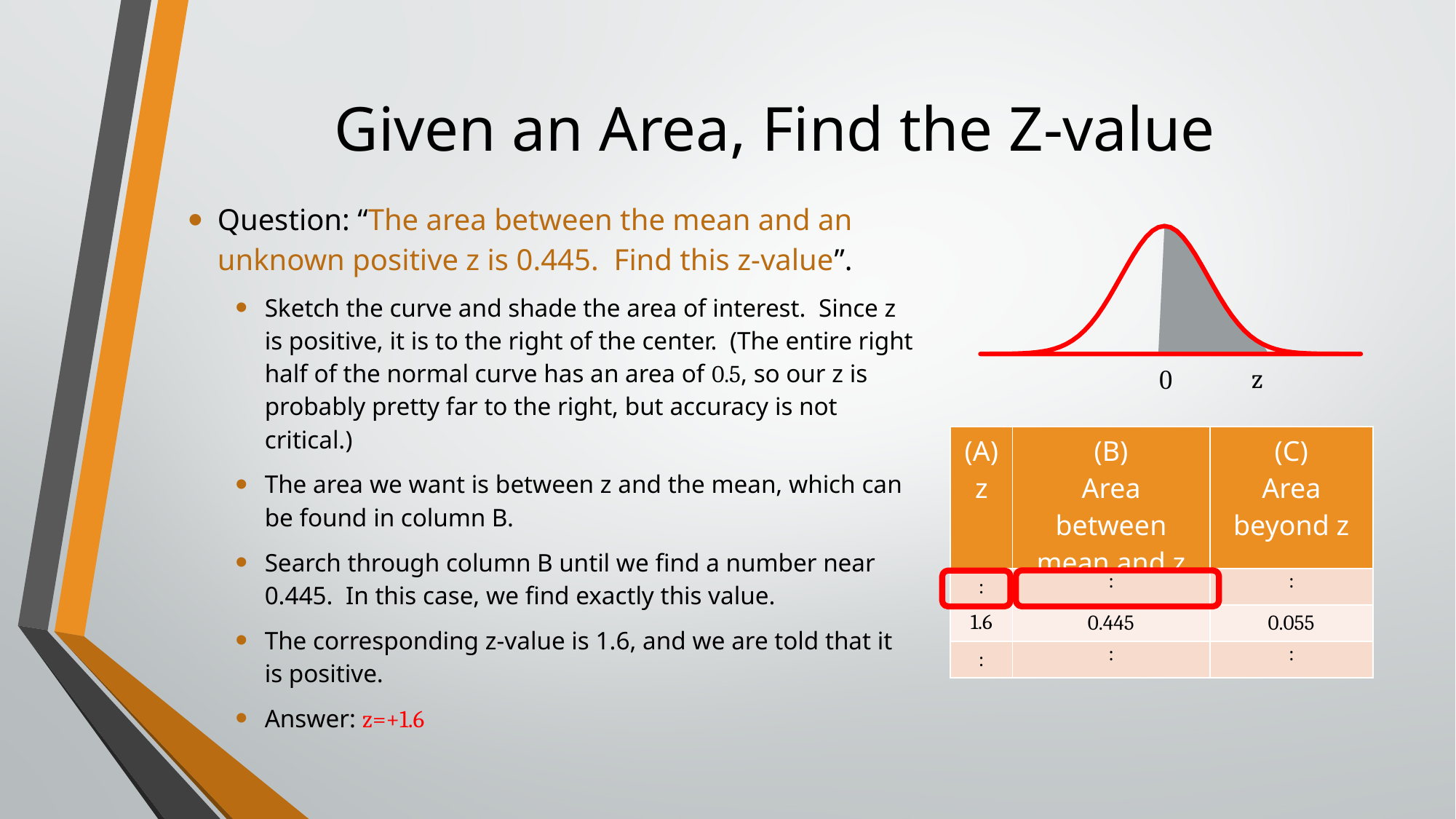
In the table, what is the value in column (C), Area beyond z, for z = 1.6? 0.055 In the table, what is the total of the column (B) and column (C) values for z = 1.6? 0.5 On the normal curve diagram, is the shaded region to the left or right of 0? Right In the table, what is the difference between the area between mean and z and the area beyond z for z = 1.6? 0.39 How many columns does the table have? 3 What kind of graphic is shown at the top right of the slide? A normal curve (bell curve) with a shaded area In the table, which is larger for z = 1.6: the area between mean and z, or the area beyond z? Area between mean and z Is the column (B) value for z = 1.6 greater or less than 0.4? greater What two labels appear on the horizontal axis of the normal curve diagram? 0 and z In the table, what is the value in column (B) for z = 1.6? 0.445